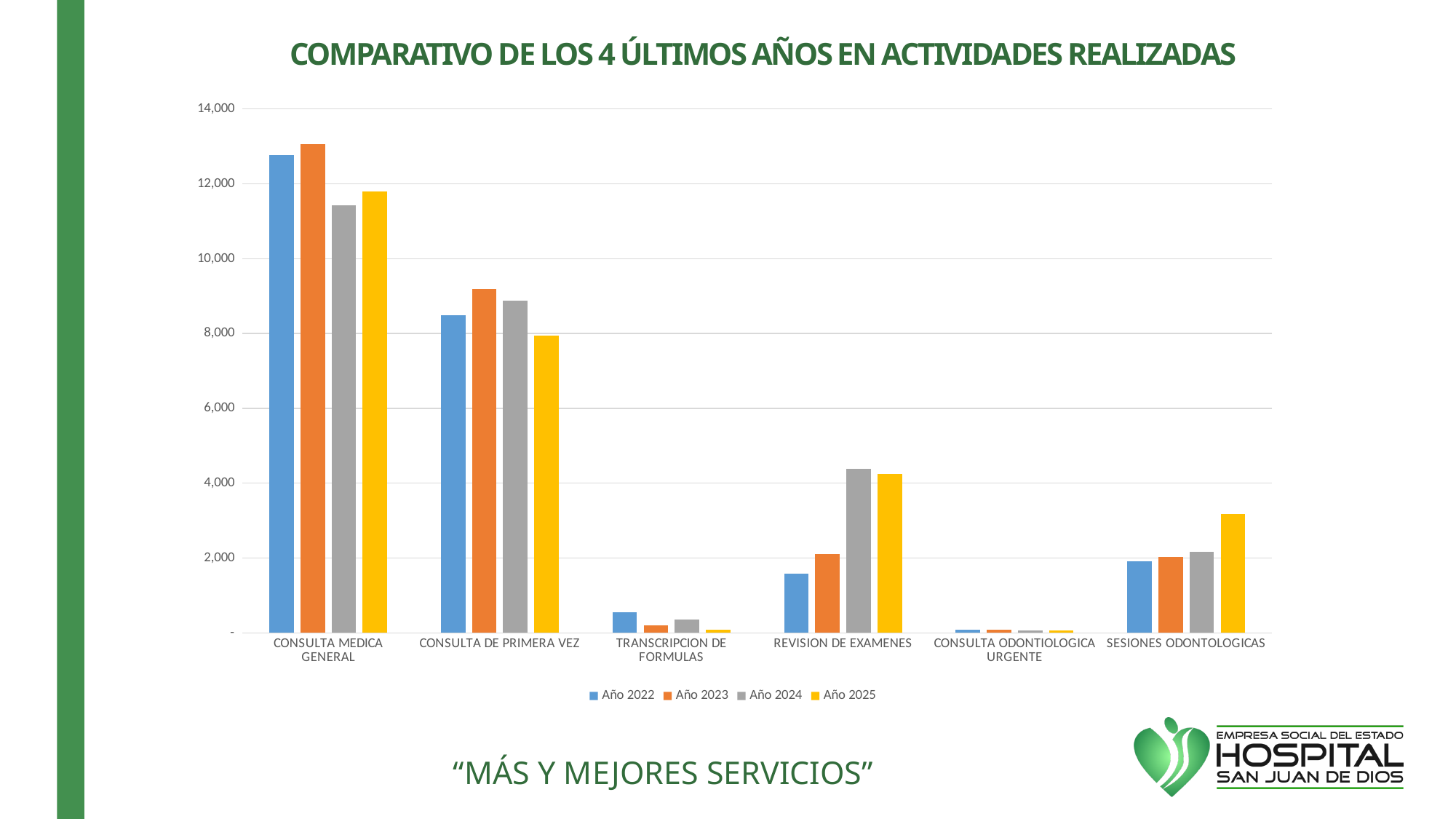
Is the Año 2024 value for REVISION DE EXAMENES greater or less than 4,000? greater How many series does the legend list? 4 Is the Año 2025 value for SESIONES ODONTOLOGICAS greater or less than 2,000? greater What kind of chart is shown on the slide? Bar chart For REVISION DE EXAMENES, which is larger: the Año 2022 bar or the Año 2024 bar? Año 2024 For CONSULTA MEDICA GENERAL, which is larger: the Año 2023 bar or the Año 2024 bar? Año 2023 Do the values for SESIONES ODONTOLOGICAS rise or fall from Año 2022 to Año 2025? rise Which year has the lowest bar for TRANSCRIPCION DE FORMULAS? Año 2025 Which category has the highest bar for Año 2023? CONSULTA MEDICA GENERAL Is the Año 2022 value for CONSULTA MEDICA GENERAL greater or less than 12,000? greater How many categories are shown on the x axis? 6